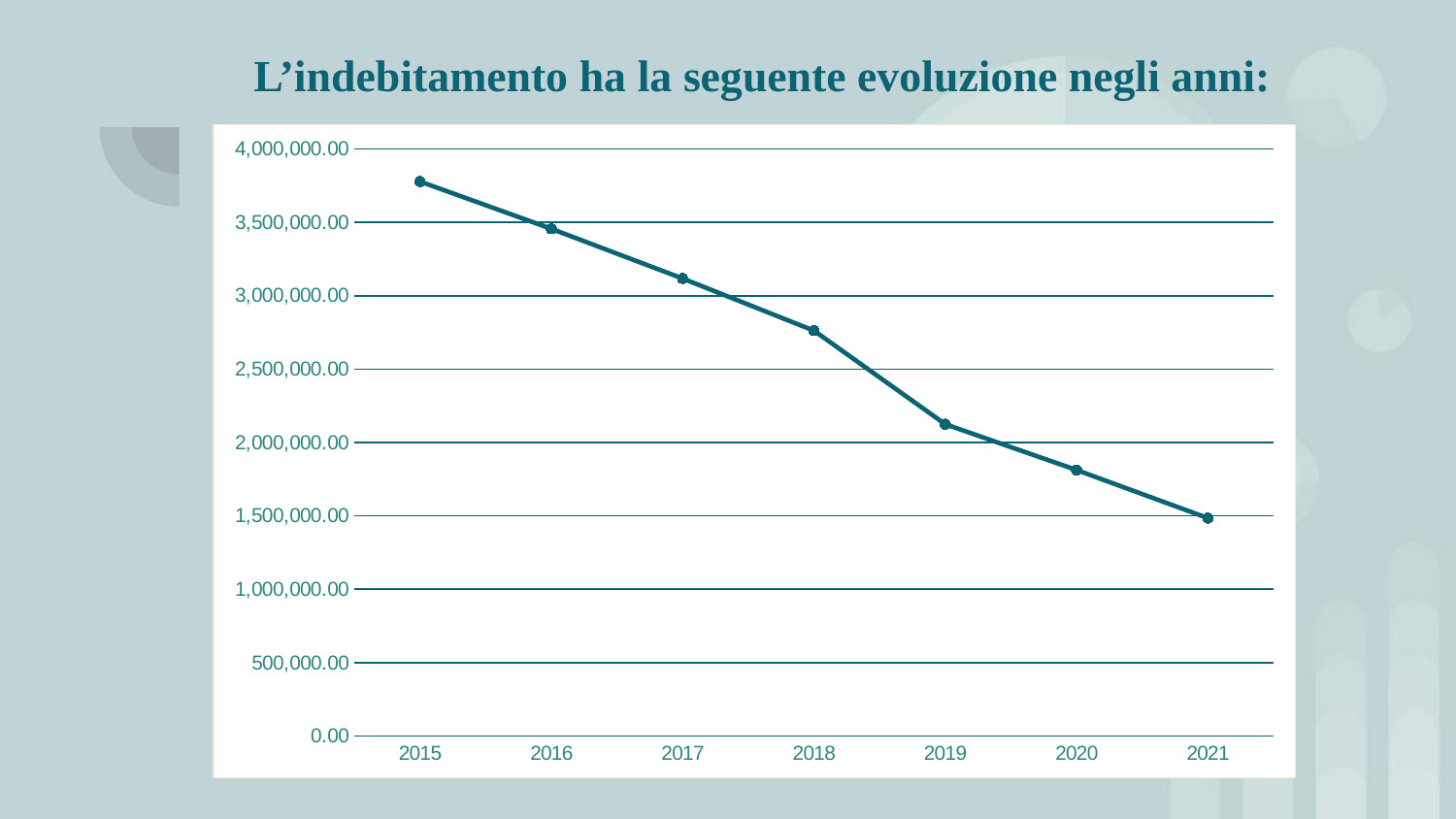
Is the value for 2019 greater or less than 2,000,000.00? greater Do the values rise or fall from 2015 to 2021? fall Is the value for 2020 greater or less than 2,000,000.00? less What is the title shown above the chart? L'indebitamento ha la seguente evoluzione negli anni: Is the value for 2018 greater or less than 3,000,000.00? less What kind of chart is shown on the slide? line chart How many years are plotted on the x axis of the chart? 7 Which year has the lowest value on the chart? 2021 Which is larger, the value for 2016 or the value for 2019? 2016 Which year has the highest value on the chart? 2015